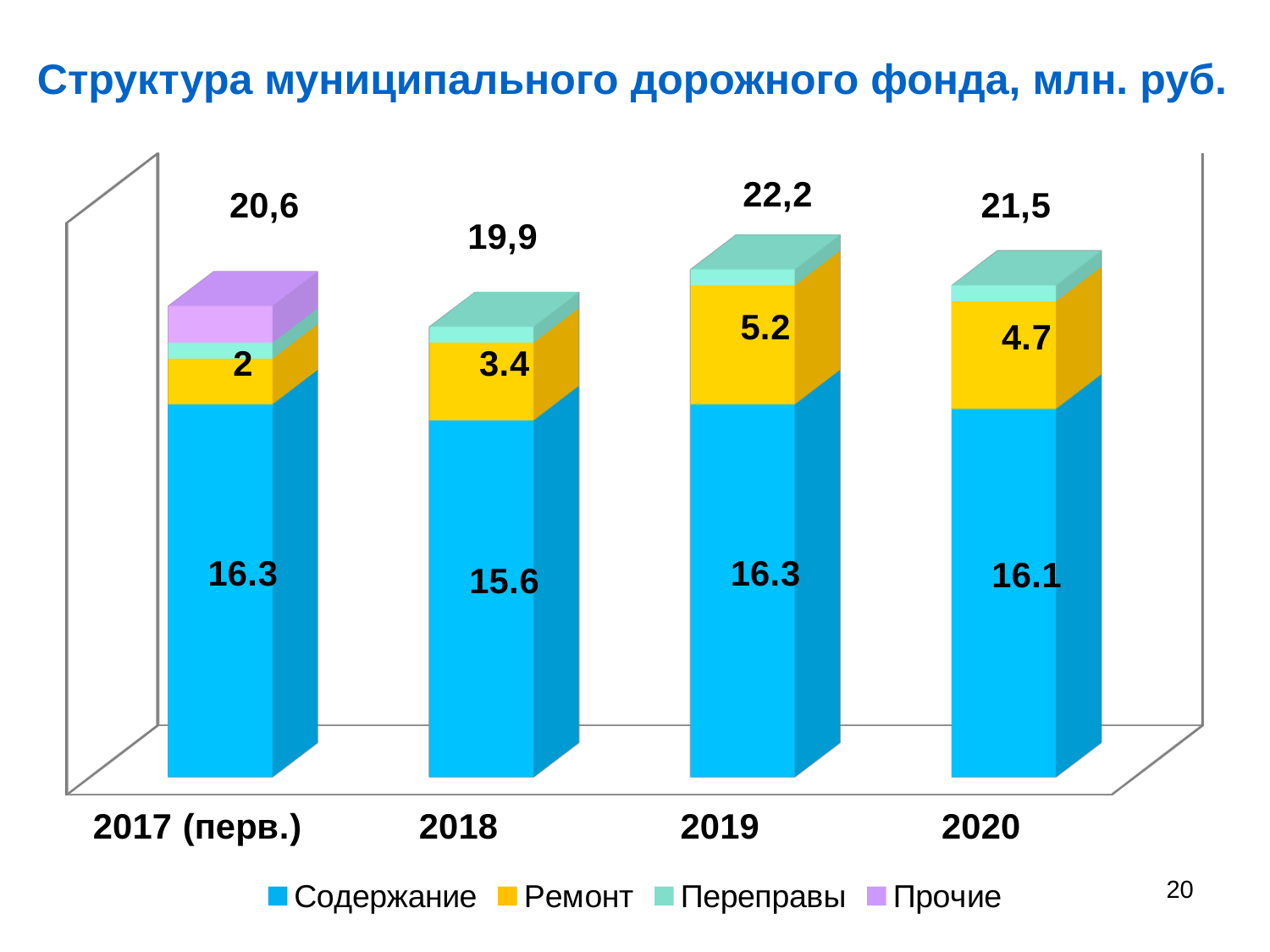
How many series does the legend list? 4 What is the value of Ремонт for 2017 (перв.)? 2 In which year is the Ремонт value the highest? 2019 What is the value of Ремонт for 2019? 5.2 What is the title of the chart? Структура муниципального дорожного фонда, млн. руб. What is the value of Содержание for 2018? 15.6 How many years (categories) are shown on the x axis? 4 What kind of chart is shown on the slide? Stacked bar chart What is the difference between the Ремонт values for 2019 and 2018? 1.8 In which year is the Содержание value the lowest? 2018 What is the total value printed above the 2019 bar? 22,2 Which year has the larger Содержание value, 2019 or 2020? 2019